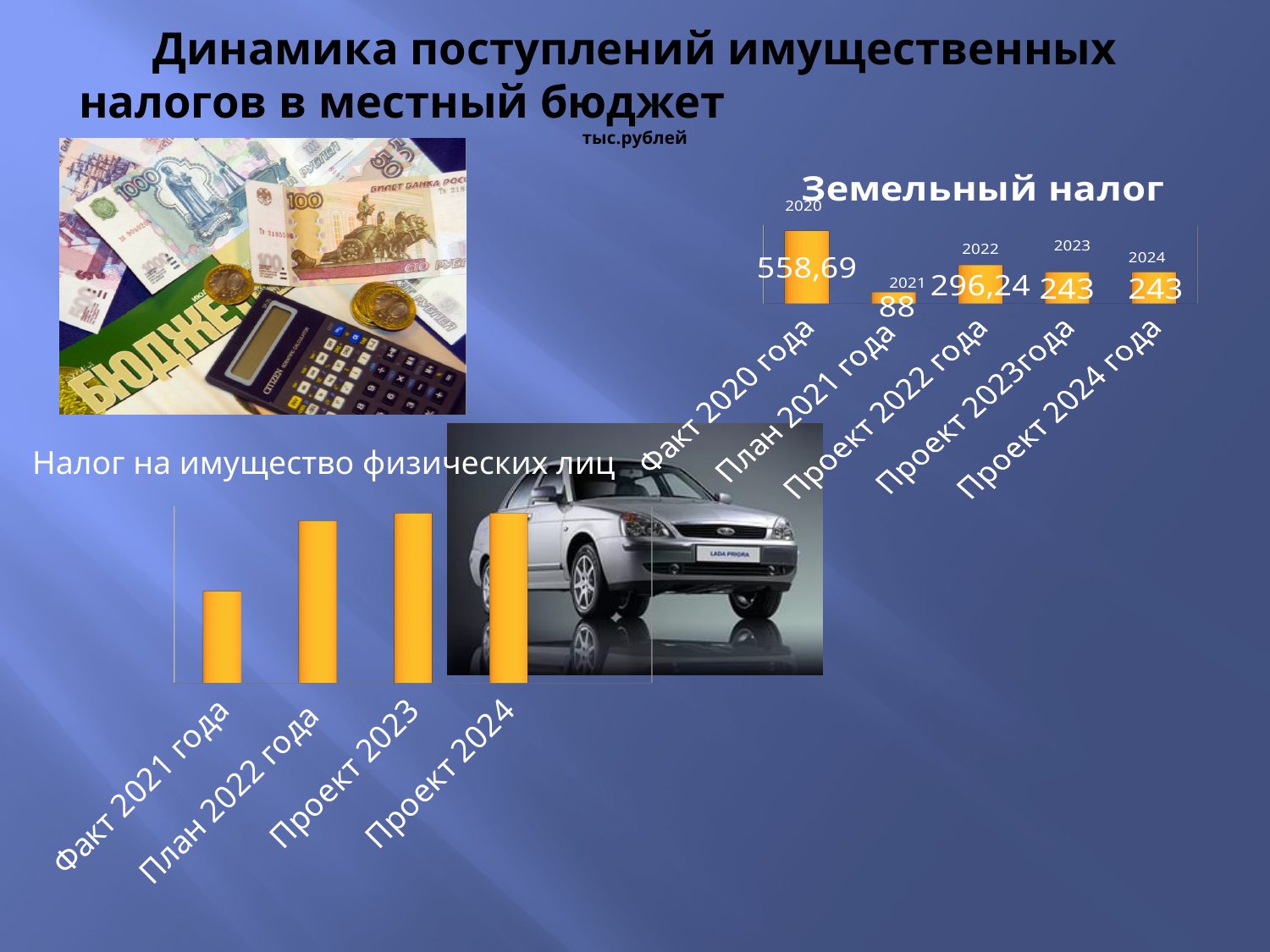
In the 'Земельный налог' chart, which category has the highest value? Факт 2020 года In the 'Земельный налог' chart, what is the value for Факт 2020 года? 558,69 In the 'Земельный налог' chart, what is the value for Проект 2022 года? 296,24 In the 'Земельный налог' chart, what is the difference between the values for Факт 2020 года and План 2021 года? 470,69 What kind of chart is the 'Налог на имущество физических лиц' chart? Bar chart In the 'Земельный налог' chart, what is the value for Проект 2024 года? 243 How many categories are shown in the 'Земельный налог' chart? 5 In the 'Земельный налог' chart, which is larger: the value for Проект 2022 года or the value for Проект 2023года? Проект 2022 года In the 'Земельный налог' chart, what is the difference between the values for Проект 2022 года and Проект 2023года? 53,24 In the 'Земельный налог' chart, which category has the lowest value? План 2021 года In the 'Земельный налог' chart, what is the value for План 2021 года? 88 In the 'Налог на имущество физических лиц' chart, which category has the lowest value? Факт 2021 года